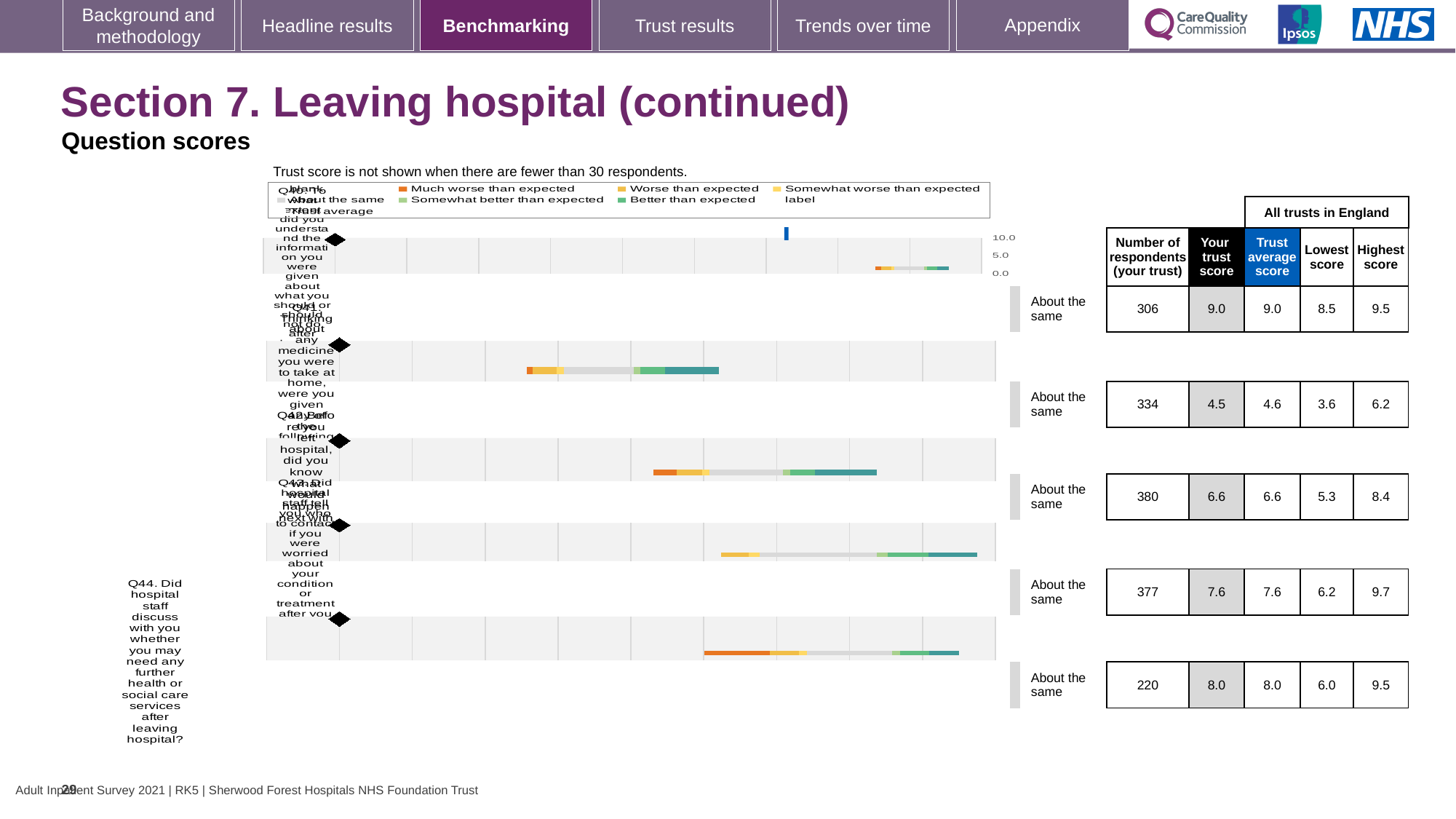
How many question rows are shown in the benchmarking chart and table? 5 What is the 'Your trust score' shown for the first (top) question row in the table? 9.0 What kind of chart is used to show the question scores on this slide? Bar chart What is the 'Highest score' across all trusts in England for Q44? 9.5 In the table, how many respondents (your trust) are shown for Q44 about further health or social care services after leaving hospital? 220 What is the 'Your trust score' for Q44 (further health or social care services after leaving hospital)? 8.0 For Q44, what is the difference between the highest score (9.5) and the lowest score (6.0)? 3.5 What benchmark category label is shown next to every question row in the chart? About the same What is the highest 'Your trust score' value shown in the table? 9.0 What is the lowest 'Your trust score' value shown in the table? 4.5 What is the 'Lowest score' shown for the second question row in the table? 3.6 Which has more respondents: the first question row (306) or Q44 (220)? The first question row (306)